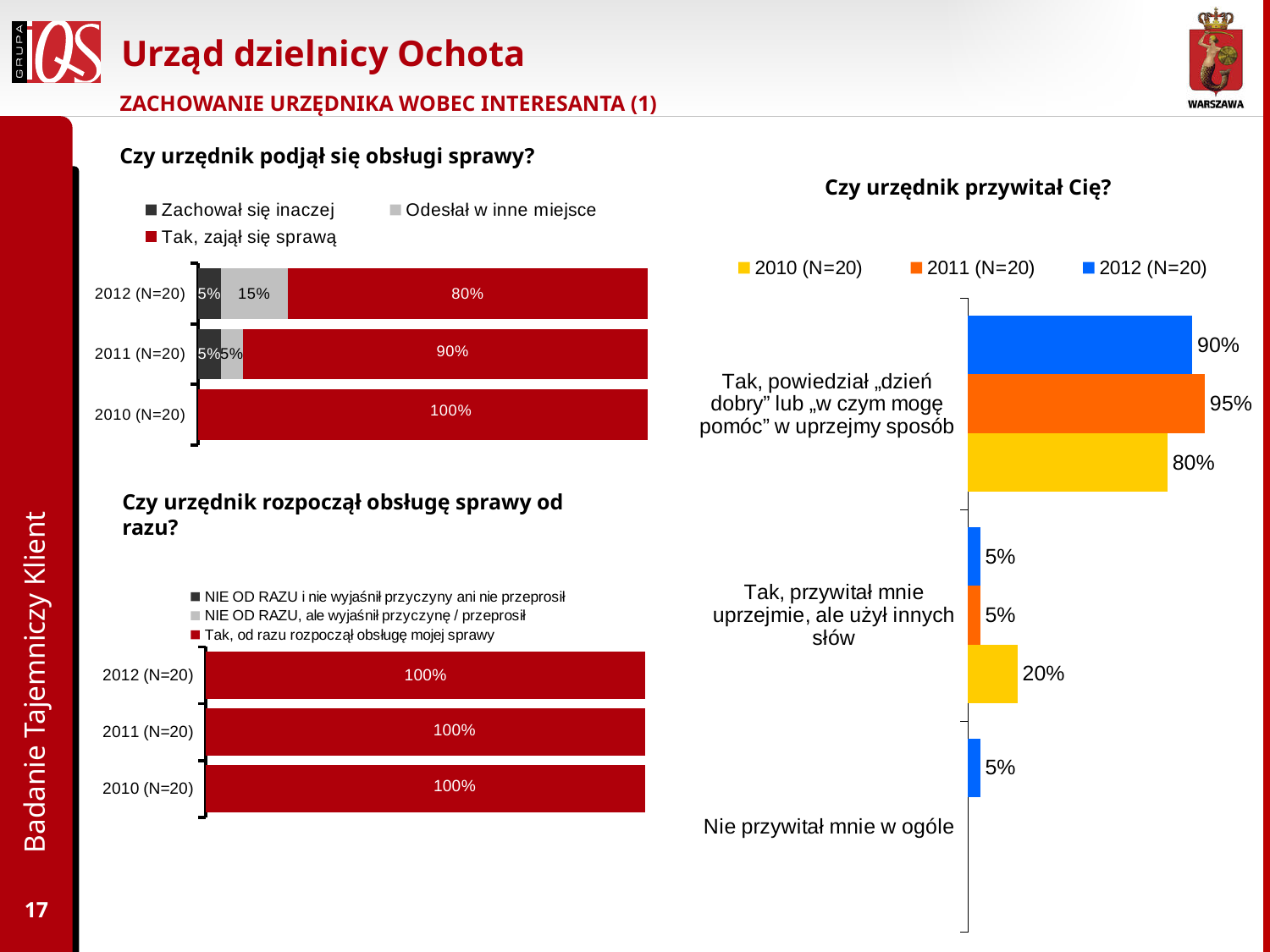
In the chart 'Czy urzędnik rozpoczął obsługę sprawy od razu?', what is the value for 'Tak, od razu rozpoczął obsługę mojej sprawy' in 2011 (N=20)? 100% In the chart 'Czy urzędnik podjął się obsługi sprawy?', what is the value for 'Tak, zajął się sprawą' in 2012 (N=20)? 80% In the chart 'Czy urzędnik podjął się obsługi sprawy?', what is the value for 'Tak, zajął się sprawą' in 2011 (N=20)? 90% In the chart 'Czy urzędnik przywitał Cię?', which is larger for 'Tak, powiedział „dzień dobry” lub „w czym mogę pomóc” w uprzejmy sposób': 2012 (N=20) or 2010 (N=20)? 2012 (N=20) In the chart 'Czy urzędnik podjął się obsługi sprawy?', what is the value for 'Odesłał w inne miejsce' in 2012 (N=20)? 15% In the chart 'Czy urzędnik podjął się obsługi sprawy?', how many series does the legend list? 3 In the chart 'Czy urzędnik podjął się obsługi sprawy?', which year has the highest value for 'Tak, zajął się sprawą'? 2010 (N=20) In the chart 'Czy urzędnik przywitał Cię?', which year has the lowest value for 'Tak, powiedział „dzień dobry” lub „w czym mogę pomóc” w uprzejmy sposób'? 2010 (N=20) In the chart 'Czy urzędnik przywitał Cię?', what is the value for 2010 (N=20) for 'Tak, przywitał mnie uprzejmie, ale użył innych słów'? 20% What kind of chart is 'Czy urzędnik rozpoczął obsługę sprawy od razu?'? bar chart In the chart 'Czy urzędnik podjął się obsługi sprawy?', what is the difference between the 'Tak, zajął się sprawą' values for 2011 (N=20) and 2012 (N=20)? 10% In the chart 'Czy urzędnik przywitał Cię?', what is the value for 2011 (N=20) for 'Tak, powiedział „dzień dobry” lub „w czym mogę pomóc” w uprzejmy sposób'? 95%